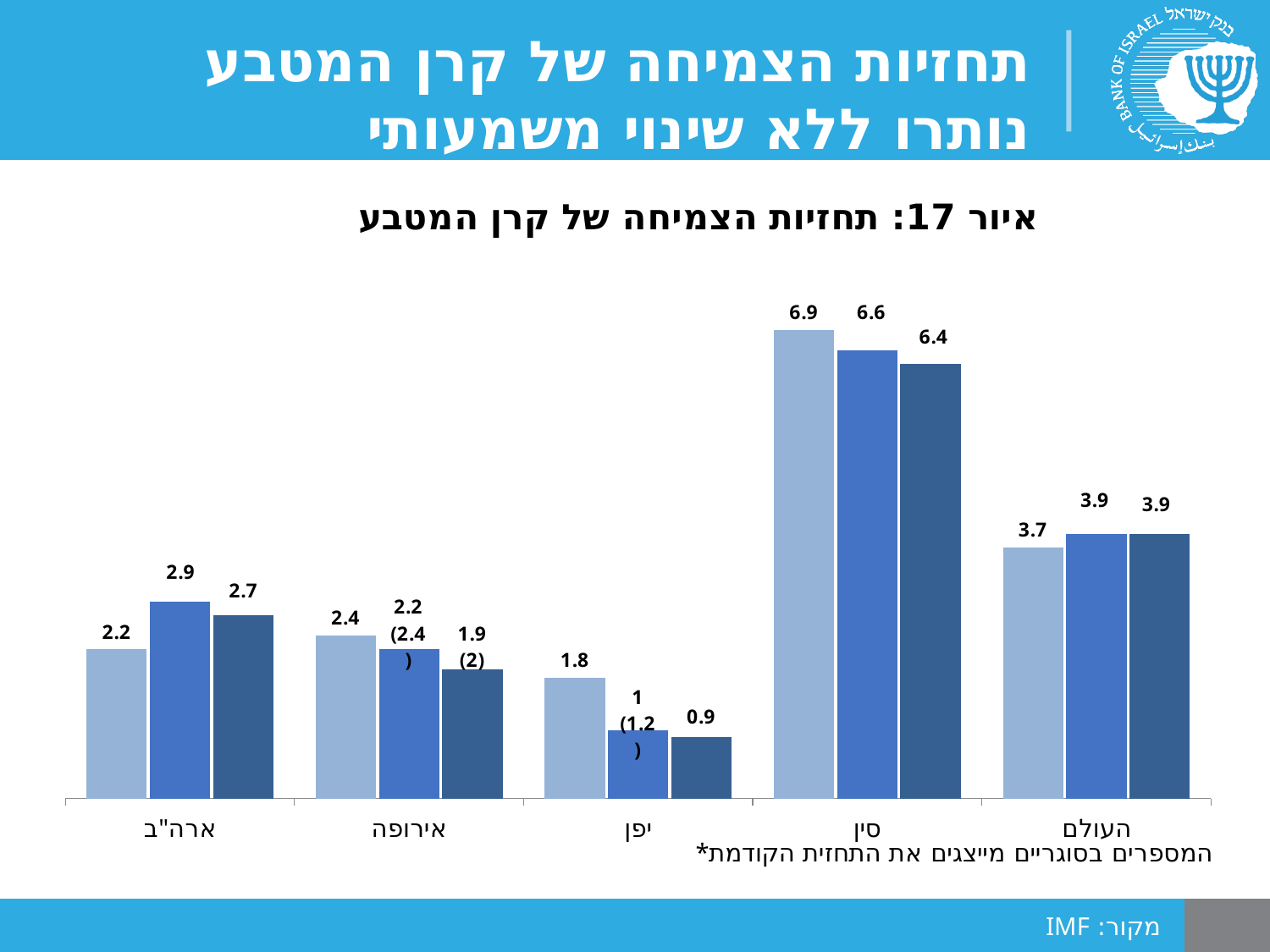
Which category has the lowest dark blue (rightmost) bar? יפן Which category has the highest light blue (leftmost) bar? סין How many categories (countries/regions) are shown on the x axis of the chart? 5 What is the value of the dark blue (rightmost) bar for ארה"ב? 2.7 What is the difference between the light blue bar and the dark blue bar for סין? 0.5 What type of chart is shown on the slide? bar chart What is the value of the light blue (leftmost) bar for יפן? 1.8 Which is larger: the medium blue (middle) bar for ארה"ב or the medium blue (middle) bar for אירופה? ארה"ב What is the title of the chart on the slide? איור 17: תחזיות הצמיחה של קרן המטבע What is the value of the medium blue (middle) bar for העולם? 3.9 What is the value of the light blue (leftmost) bar for סין? 6.9 What is the source cited at the bottom of the slide? IMF